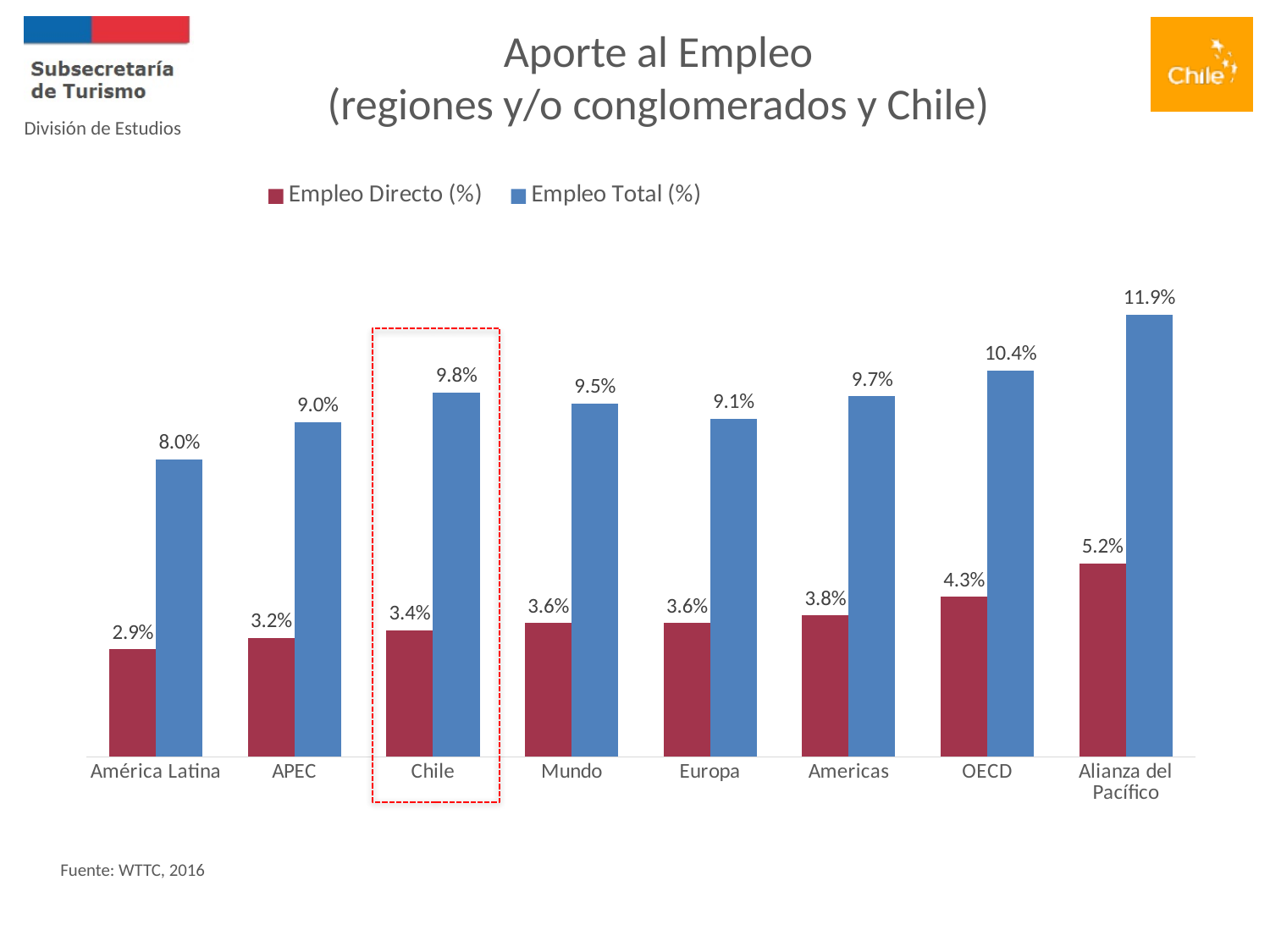
What is the difference between the Empleo Total (%) values for Alianza del Pacífico and América Latina? 3.9% How many categories are shown on the x axis? 8 What is the Empleo Directo (%) value for OECD? 4.3% Which category has the lowest Empleo Directo (%) value? América Latina What is the Empleo Total (%) value for Chile? 9.8% Which is larger, the Empleo Total (%) value for OECD or for Americas? OECD How many series does the legend list? 2 What kind of chart is shown on the slide? Bar chart Which category has the highest Empleo Total (%) value? Alianza del Pacífico What is the difference between the Empleo Total (%) and Empleo Directo (%) values for Chile? 6.4% What is the source cited below the chart? WTTC, 2016 What is the Empleo Directo (%) value for América Latina? 2.9%